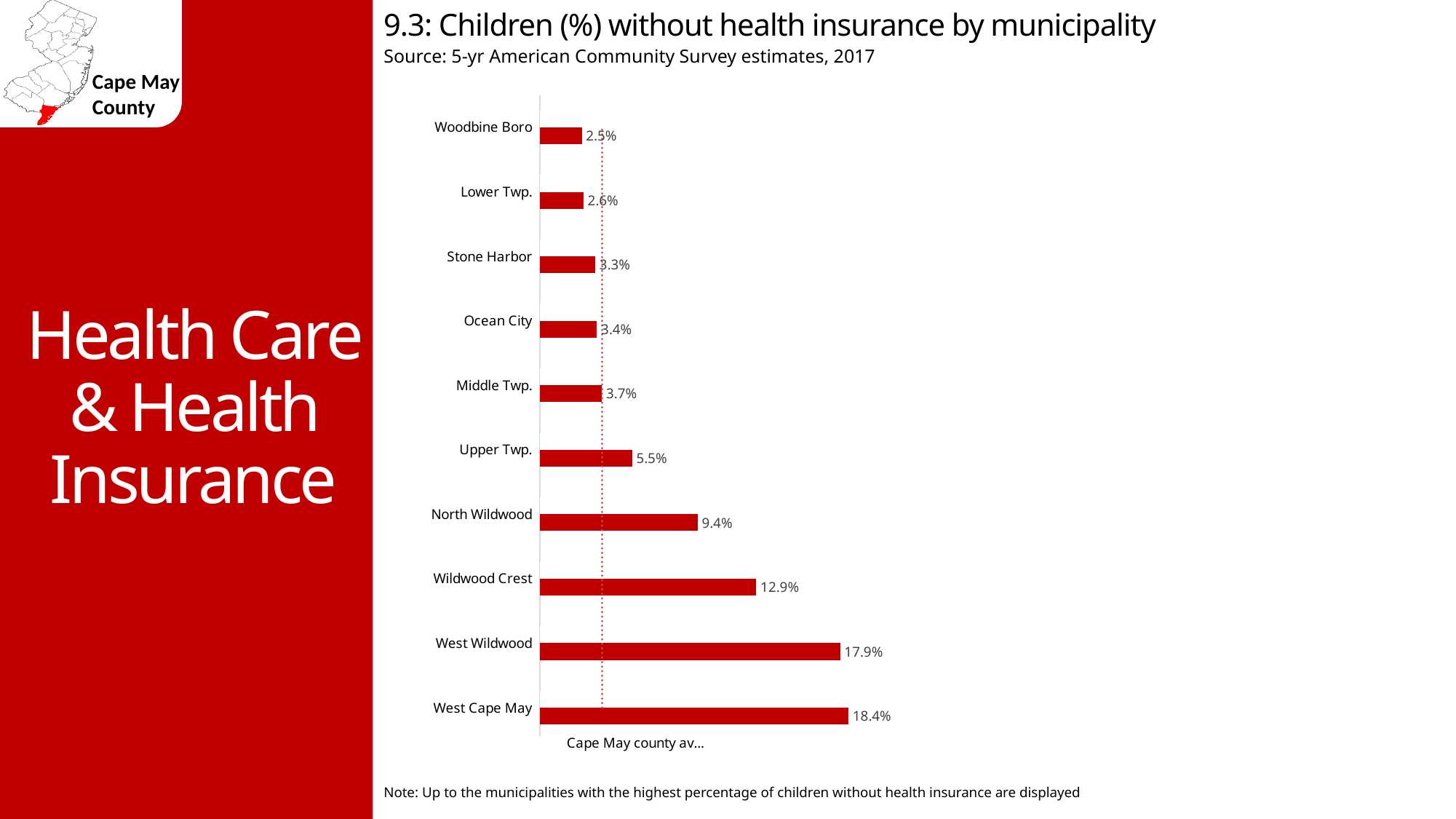
What is the title of the chart? 9.3: Children (%) without health insurance by municipality What percentage is shown for Upper Twp.? 5.5% Which municipality has the lowest percentage of children without health insurance? Woodbine Boro What kind of chart is used on this slide? Bar chart Which has a higher percentage of children without health insurance, Wildwood Crest or North Wildwood? Wildwood Crest What is the value shown for North Wildwood? 9.4% What does the dotted vertical line on the chart represent? Cape May county average Which municipality has the highest percentage of children without health insurance? West Cape May What percentage of children are without health insurance in West Cape May? 18.4% How many municipalities are shown in the chart? 10 What is the difference between the values for West Cape May and Woodbine Boro? 15.9% What is the difference between the values for West Wildwood and Wildwood Crest? 5.0%